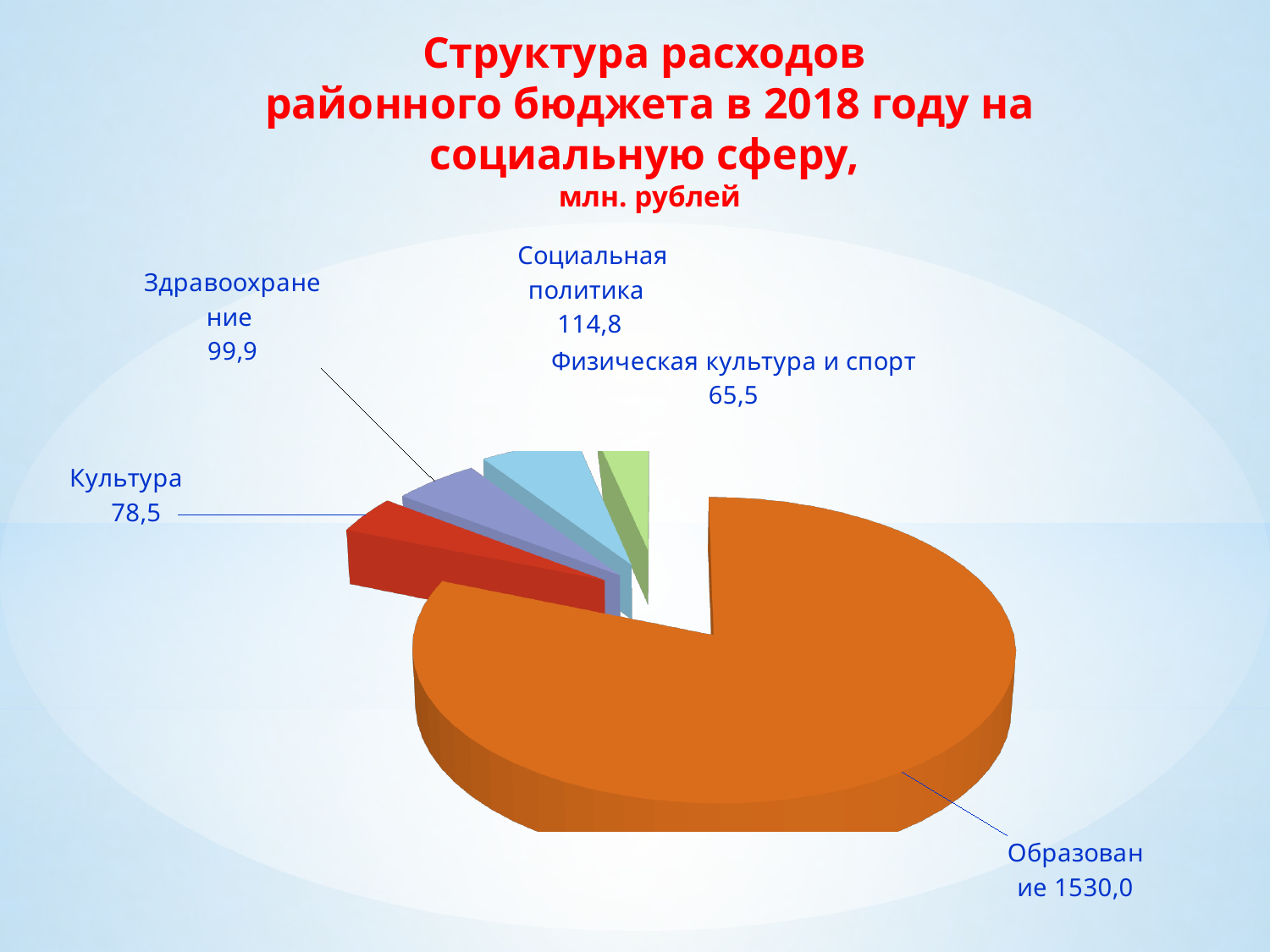
How many slices does the pie chart have? 5 What is the value for Социальная политика? 114,8 What type of chart is shown on the slide? Pie chart What is the difference between the values for Социальная политика and Здравоохранение? 14,9 What is the value for Образование? 1530,0 Which category has the largest slice of the pie? Образование Which is larger, the value for Культура or the value for Здравоохранение? Здравоохранение Which category has the smallest slice of the pie? Физическая культура и спорт What is the value for Физическая культура и спорт? 65,5 What is the value for Здравоохранение? 99,9 What unit of measurement is stated in the chart title? млн. рублей What is the difference between the values for Культура and Физическая культура и спорт? 13,0